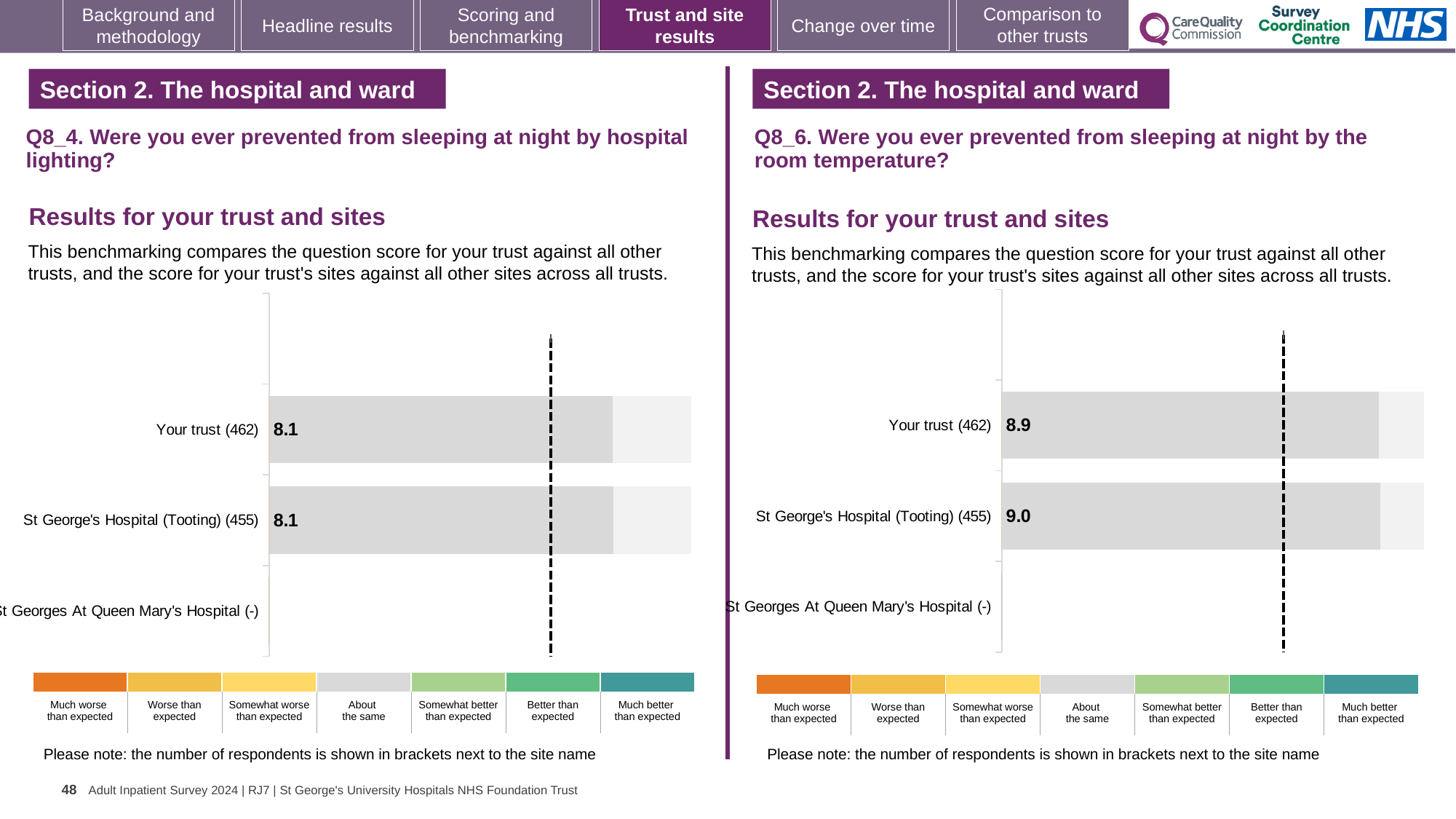
How many respondents are shown in brackets for Your trust on the Q8_6 chart (right)? 462 What kind of chart is used on the Q8_6 chart (right)? Bar chart On the Q8_6 chart (right), what is the score for St George's Hospital (Tooting) (455)? 9.0 How many respondents are shown in brackets for St George's Hospital (Tooting) on the Q8_4 chart (left)? 455 On the Q8_4 chart (left), what is the score for St George's Hospital (Tooting) (455)? 8.1 On the Q8_4 chart (left), what is the score for Your trust (462)? 8.1 On the Q8_4 chart (left), what is the difference between the score for Your trust (462) and the score for St George's Hospital (Tooting) (455)? 0 On the Q8_6 chart (right), what is the score for Your trust (462)? 8.9 How many categories are listed on the Q8_6 chart (right)? 3 On the Q8_6 chart (right), what is the difference between the score for St George's Hospital (Tooting) (455) and the score for Your trust (462)? 0.1 On the Q8_4 chart (left), which category has no score shown? St Georges At Queen Mary's Hospital (-) How many categories are listed on the Q8_4 chart (left)? 3